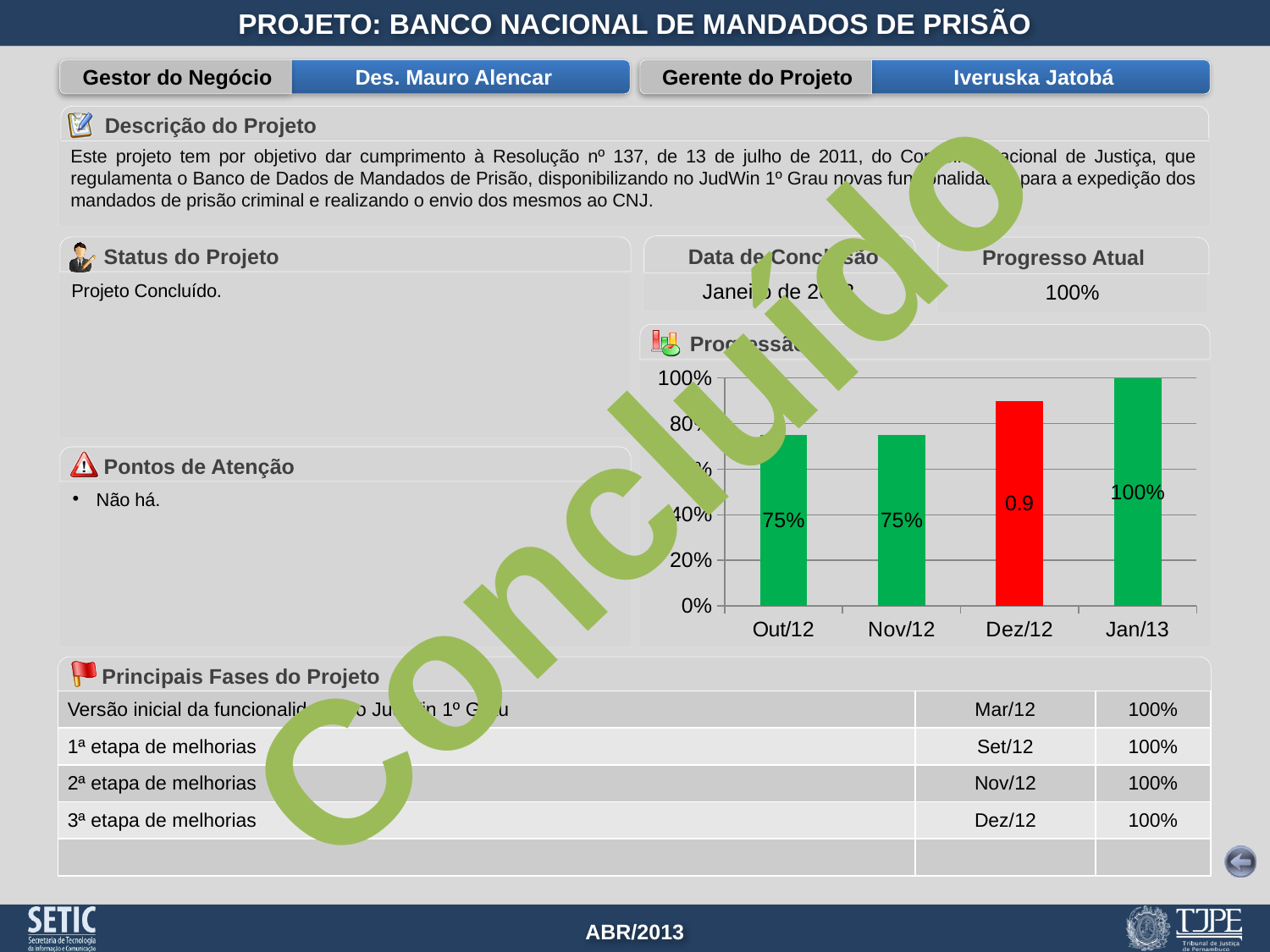
What data label is printed on the Dez/12 bar? 0.9 Which month's bar is coloured red in the chart? Dez/12 Do the values in the chart rise or fall from Out/12 to Jan/13? Rise Which month has the highest bar in the chart? Jan/13 What is the difference between the Jan/13 value and the Out/12 value? 25% How many months are plotted on the x axis of the chart? 4 Which is larger, the value for Jan/13 or the value for Out/12? Jan/13 Is the value for Dez/12 greater or less than 80%? greater What is the value shown for Out/12 in the chart? 75% What is the value shown for Nov/12 in the chart? 75% What kind of chart is shown on the slide? Bar chart What is the value shown for Jan/13 in the chart? 100%